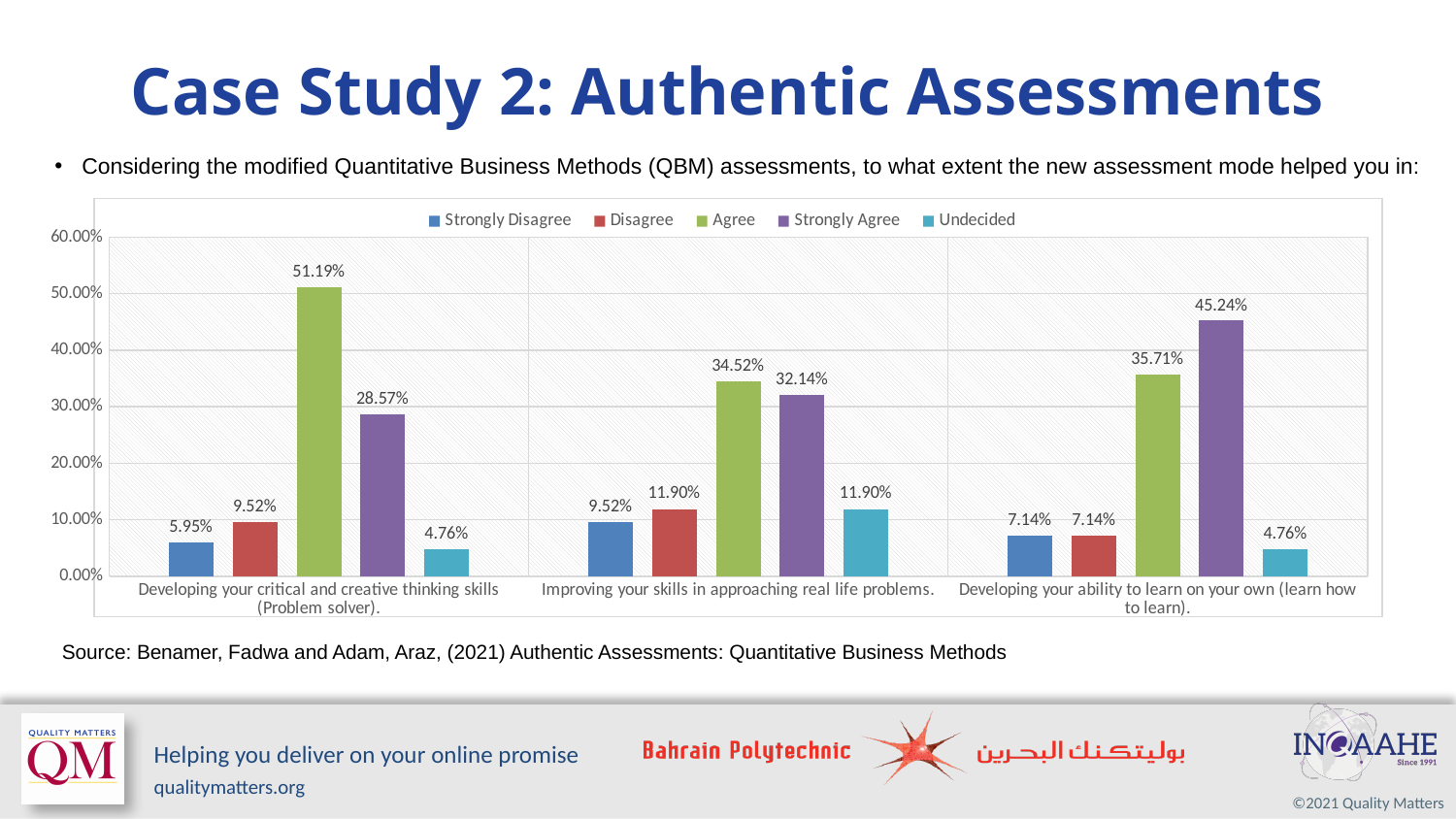
What is the difference between the Agree and Strongly Agree values for 'Developing your critical and creative thinking skills (Problem solver)'? 22.62% Which series has the highest value for 'Improving your skills in approaching real life problems'? Agree Is the Agree value for 'Developing your critical and creative thinking skills (Problem solver)' greater or less than 50.00%? greater Which series has the lowest value for 'Developing your critical and creative thinking skills (Problem solver)'? Undecided What is the Agree value for 'Developing your critical and creative thinking skills (Problem solver)'? 51.19% What is the Undecided value for 'Improving your skills in approaching real life problems'? 11.90% How many series does the legend list? 5 What is the Strongly Agree value for 'Developing your ability to learn on your own (learn how to learn)'? 45.24% For 'Developing your ability to learn on your own (learn how to learn)', which is larger: Agree or Strongly Agree? Strongly Agree What colour are the Agree bars in the chart? Green What kind of chart is shown on the slide? Bar chart How many categories are shown on the x axis? 3